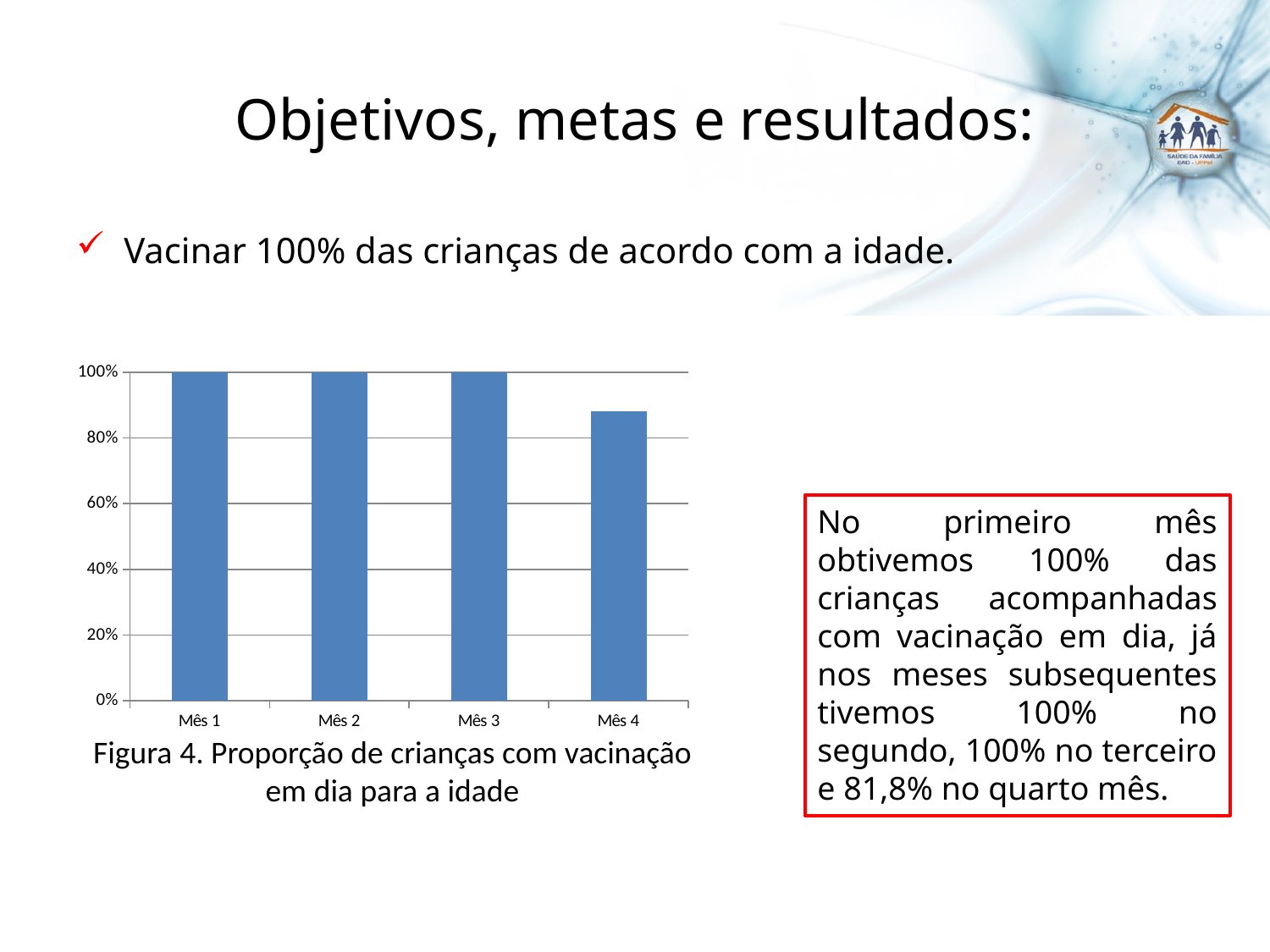
Is the value for Mês 4 greater or less than 80%? greater What is the caption (figure title) given below the chart? Figura 4. Proporção de crianças com vacinação em dia para a idade What is the value for Mês 2 in the chart? 100% Which month has the lowest value in the chart? Mês 4 What is the value for Mês 1 in the chart? 100% What colour are the bars in the chart? blue Is the value for Mês 4 greater or less than 100%? less Which is larger, the value for Mês 3 or the value for Mês 4? Mês 3 Do the values rise or fall from Mês 3 to Mês 4? fall How many months (categories) are plotted on the x axis of the chart? 4 What kind of chart is shown on the slide? bar chart What is the value for Mês 3 in the chart? 100%